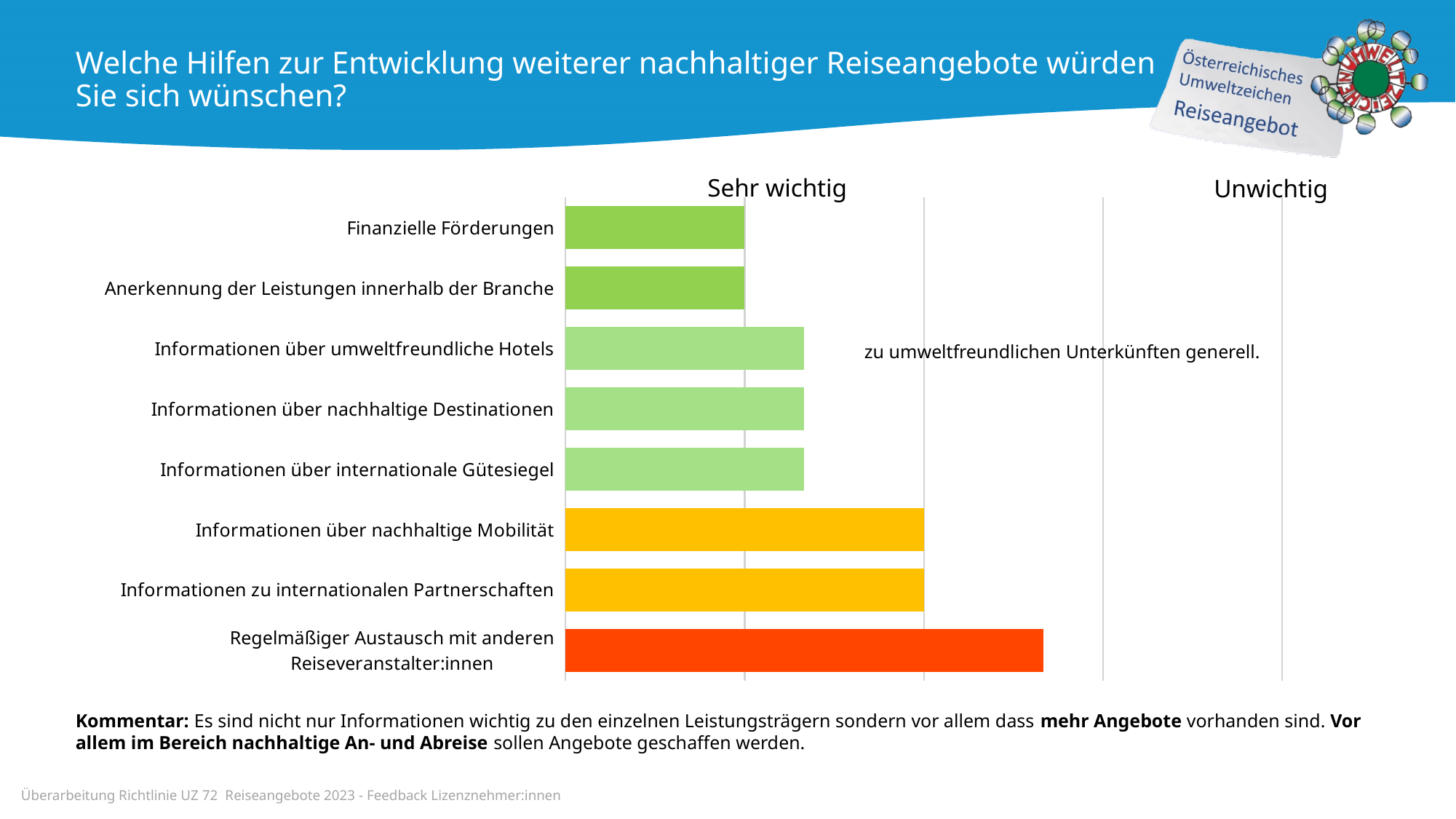
Which category has the longest bar in the chart? Regelmäßiger Austausch mit anderen Reiseveranstalter:innen How many categories are plotted in the chart? 8 Which bar is longer: 'Anerkennung der Leistungen innerhalb der Branche' or 'Informationen über internationale Gütesiegel'? Informationen über internationale Gütesiegel What label appears at the left end of the chart's horizontal axis? Sehr wichtig Which bar is longer: 'Informationen zu internationalen Partnerschaften' or 'Informationen über nachhaltige Destinationen'? Informationen zu internationalen Partnerschaften Which bar is longer: 'Informationen über umweltfreundliche Hotels' or 'Regelmäßiger Austausch mit anderen Reiseveranstalter:innen'? Regelmäßiger Austausch mit anderen Reiseveranstalter:innen Which category's bar is coloured red in the chart? Regelmäßiger Austausch mit anderen Reiseveranstalter:innen What kind of chart is shown on the slide? bar chart